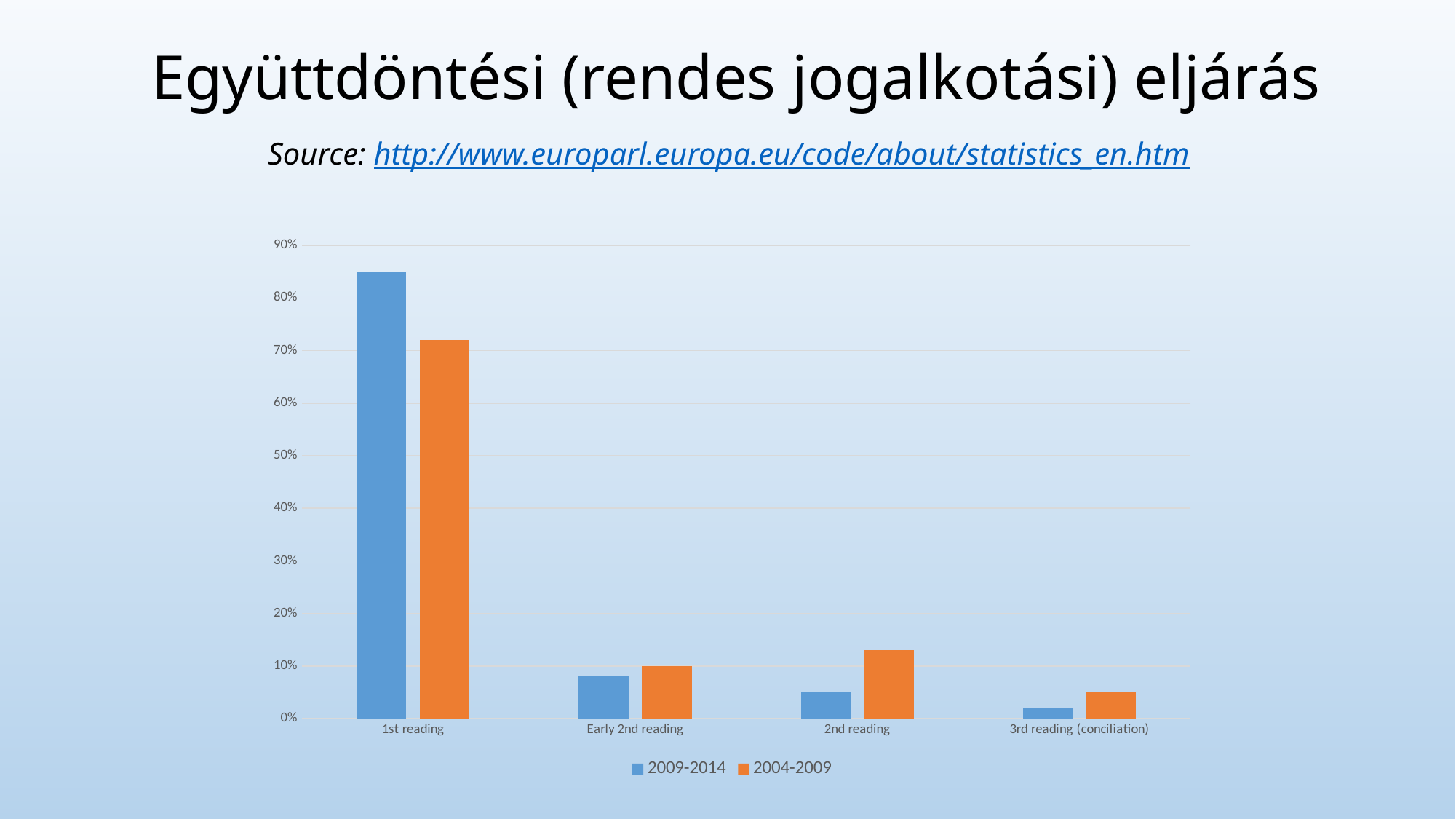
For 1st reading, which series has the larger value, 2009-2014 or 2004-2009? 2009-2014 Which category has the lowest value for the 2004-2009 series? 3rd reading (conciliation) Is the value for 2nd reading in the 2004-2009 series greater or less than 10%? greater How many categories are shown on the x axis? 4 Which category has the lowest value for the 2009-2014 series? 3rd reading (conciliation) Which colour represents the 2004-2009 series in the legend? orange For 2nd reading, which series has the larger value, 2009-2014 or 2004-2009? 2004-2009 What kind of chart is shown on the slide? bar chart Is the value for 1st reading in the 2009-2014 series greater or less than 80%? greater Which category has the highest value for the 2009-2014 series? 1st reading Is the value for 1st reading in the 2004-2009 series greater or less than 80%? less How many series does the legend list? 2